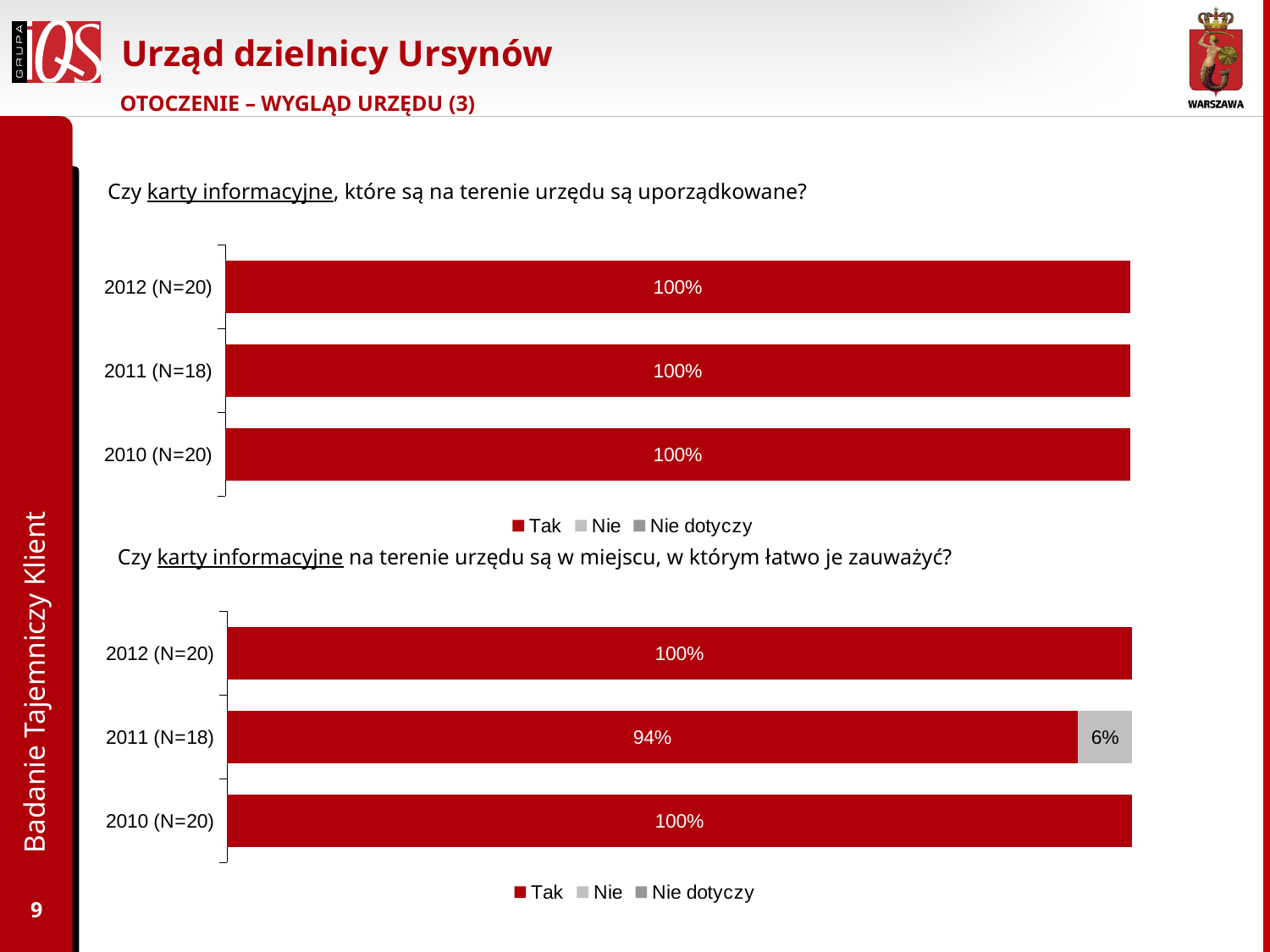
In the bottom chart ("Czy karty informacyjne na terenie urzędu są w miejscu, w którym łatwo je zauważyć?"), what is the value for "Tak" in 2011 (N=18)? 94% What are the legend entries of the top chart? Tak, Nie, Nie dotyczy In the top chart ("Czy karty informacyjne, które są na terenie urzędu są uporządkowane?"), what is the value for "Tak" in 2012 (N=20)? 100% What type of chart is the top chart? Bar chart In the bottom chart, which is larger: the "Tak" value for 2011 (N=18) or the "Tak" value for 2010 (N=20)? 2010 (N=20) How many series does the legend of the bottom chart list? 3 In the bottom chart, what is the total of the stacked bar for 2011 (N=18)? 100% In the bottom chart, what is the difference between the "Tak" value in 2012 (N=20) and the "Tak" value in 2011 (N=18)? 6% In the bottom chart, what is the value for "Tak" in 2010 (N=20)? 100% In the bottom chart, what is the value for "Nie" in 2011 (N=18)? 6% How many year categories are shown in the top chart? 3 In the bottom chart, which year has the lowest value for "Tak"? 2011 (N=18)